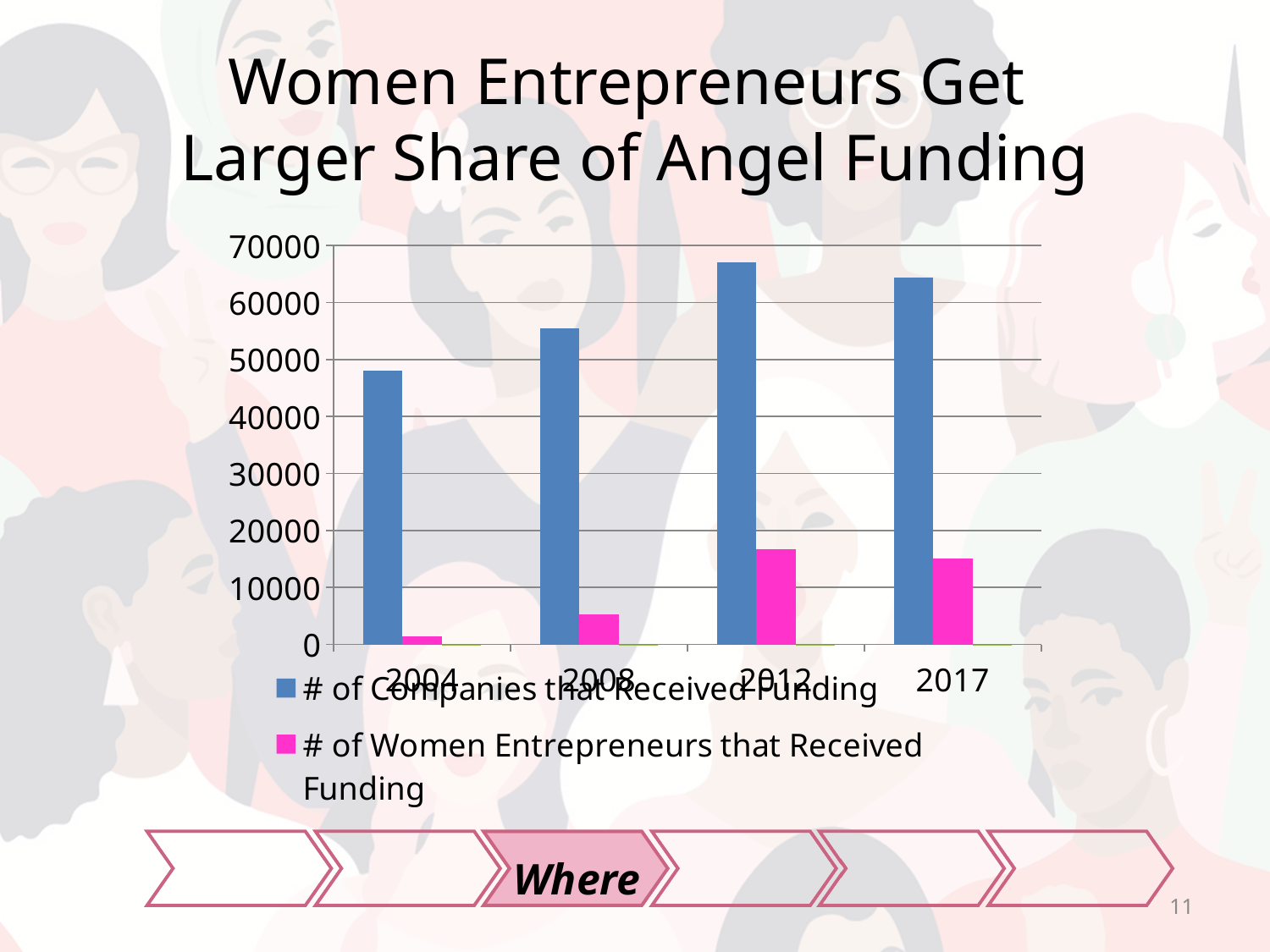
How many years are shown on the x axis? 4 Which is larger: # of Companies that Received Funding in 2012 or in 2017? 2012 Is the value for # of Companies that Received Funding in 2004 greater or less than 50000? less What kind of chart is shown on the slide? bar chart Which year has the lowest value for # of Women Entrepreneurs that Received Funding? 2004 Is the value for # of Women Entrepreneurs that Received Funding in 2008 greater or less than 10000? less Which year has the highest value for # of Companies that Received Funding? 2012 How many series does the legend list? 2 Is the value for # of Women Entrepreneurs that Received Funding in 2012 greater or less than 10000? greater What colour are the bars for # of Women Entrepreneurs that Received Funding? pink Which year has the lowest value for # of Companies that Received Funding? 2004